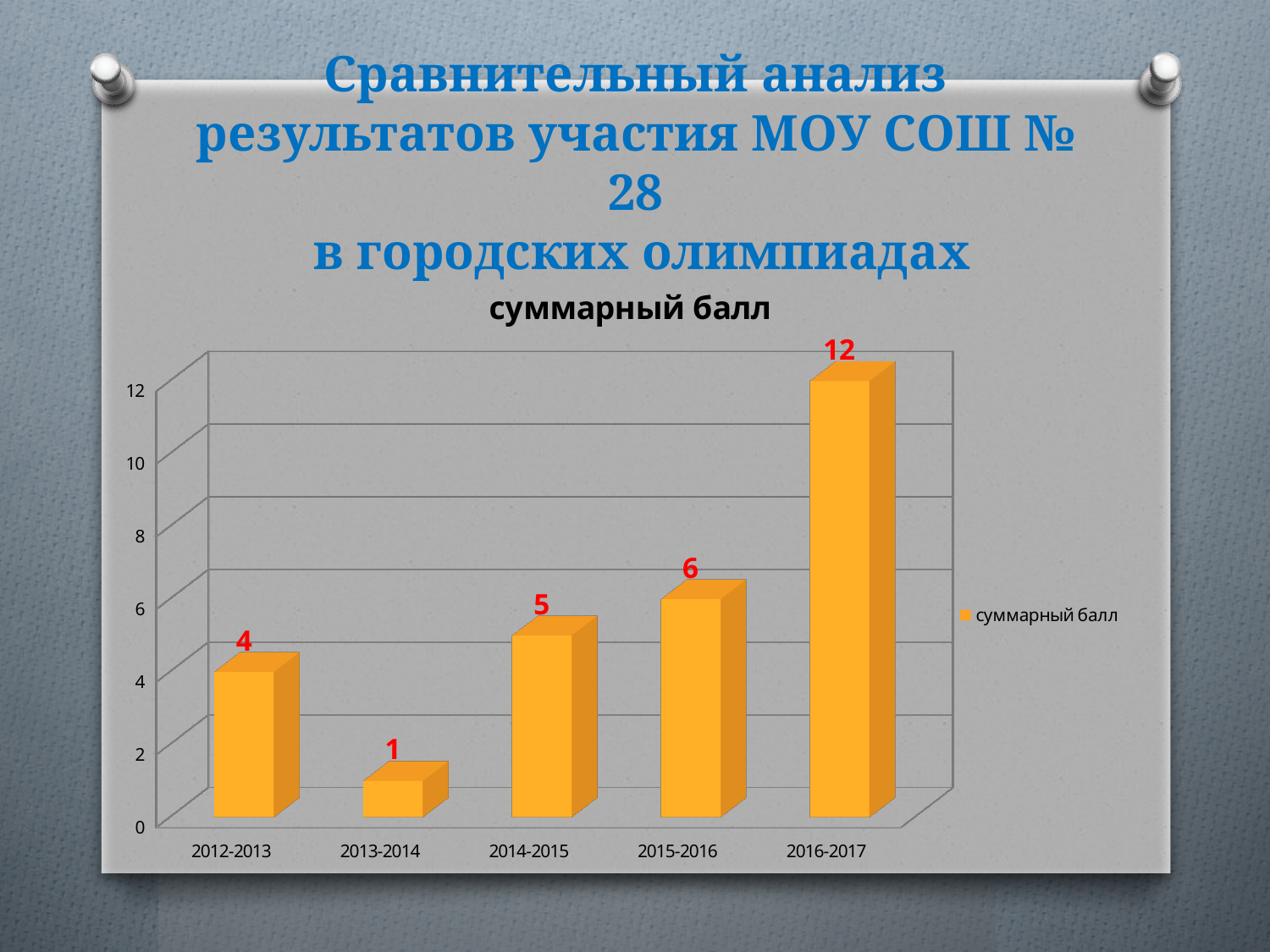
What is the суммарный балл for 2016-2017? 12 What kind of chart is shown on the slide? bar chart Which is larger, the суммарный балл for 2014-2015 or for 2012-2013? 2014-2015 Which academic year has the lowest суммарный балл? 2013-2014 How many series does the legend list? 1 How many academic years are shown on the chart? 5 What is the суммарный балл for 2013-2014? 1 Which academic year has the highest суммарный балл? 2016-2017 What is the difference between the суммарный балл for 2016-2017 and 2015-2016? 6 What is the суммарный балл for 2012-2013? 4 What is the title of the chart? суммарный балл Does the суммарный балл rise or fall from 2013-2014 to 2016-2017? rise